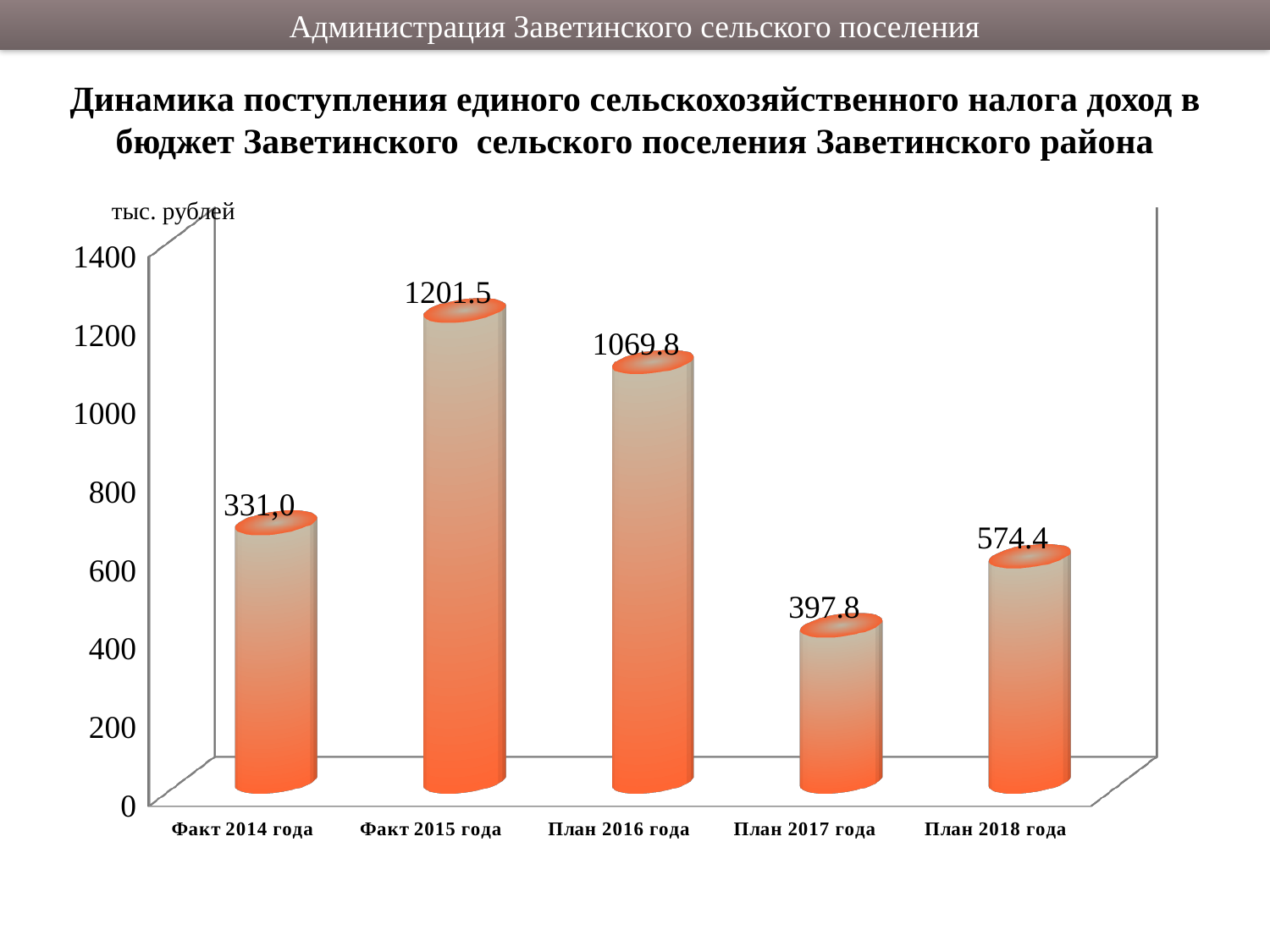
What kind of chart is shown on the slide? bar chart What is the value for План 2017 года? 397.8 How many categories are shown on the x axis? 5 What is the difference between the values for Факт 2015 года and План 2016 года? 131.7 Is the value for План 2016 года greater or less than 1000? greater What value is labelled on the bar for Факт 2014 года? 331,0 What is the value for План 2018 года? 574.4 What is the value for Факт 2015 года? 1201.5 What is the value for План 2016 года? 1069.8 What is the difference between the values for План 2018 года and План 2017 года? 176.6 Which is larger, the value for План 2016 года or the value for План 2018 года? План 2016 года Which category has the highest value? Факт 2015 года